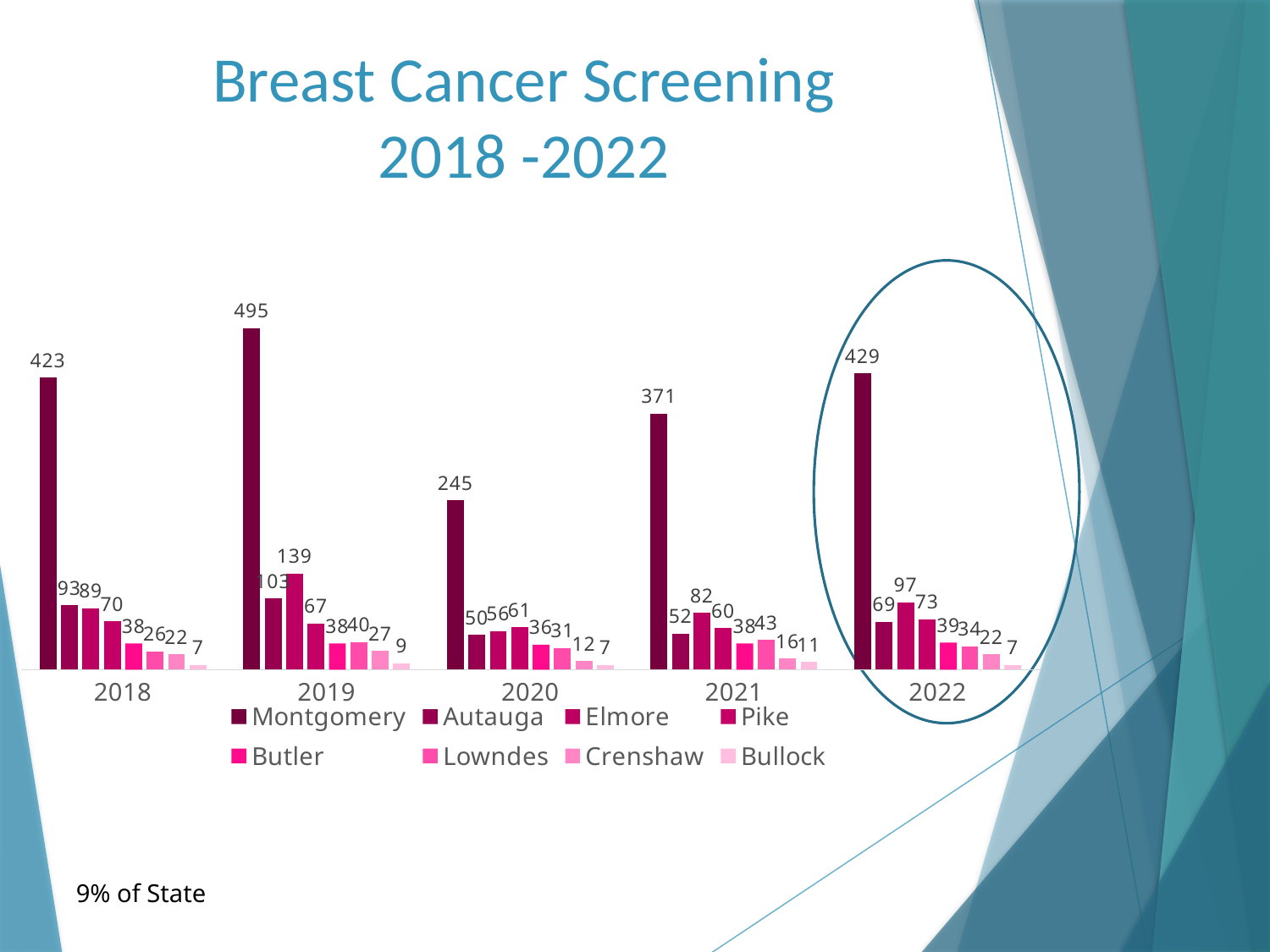
How many series does the legend list? 8 What is the value for Elmore in 2019? 139 What is the value for Montgomery in 2019? 495 How many years are shown on the x axis? 5 What is the difference between the Montgomery values for 2022 and 2021? 58 Which year on the x axis is circled on the slide? 2022 In which year is the Montgomery value lowest? 2020 In which year is the Montgomery value highest? 2019 What is the value for Montgomery in 2020? 245 What is the value for Bullock in 2021? 11 Which is larger in 2022, the value for Autauga or the value for Elmore? Elmore What type of chart is shown on the slide? bar chart